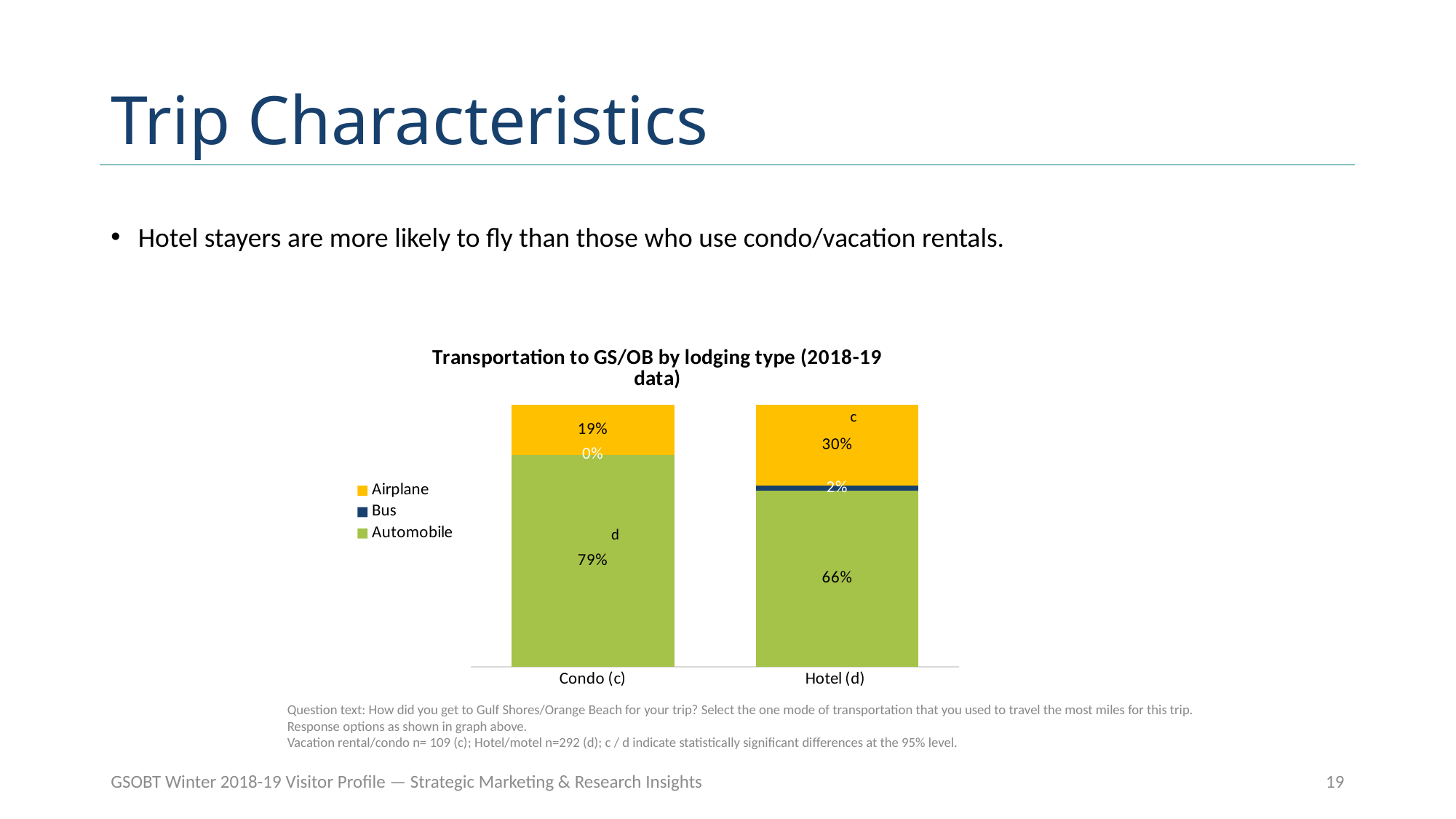
What percentage of Hotel (d) visitors traveled by Automobile? 66% What kind of chart is shown on the slide? Stacked bar chart What percentage of Condo (c) visitors traveled by Bus? 0% What percentage of Hotel (d) visitors traveled by Airplane? 30% How many series does the legend list? 3 What is the title of the chart? Transportation to GS/OB by lodging type (2018-19 data) What percentage of Hotel (d) visitors traveled by Bus? 2% Which lodging type has the higher Airplane share? Hotel (d) What is the difference in Airplane share between Hotel (d) and Condo (c)? 11% What is the difference in Automobile share between Condo (c) and Hotel (d)? 13% What percentage of Condo (c) visitors traveled by Automobile? 79% How many lodging types are shown on the x axis? 2